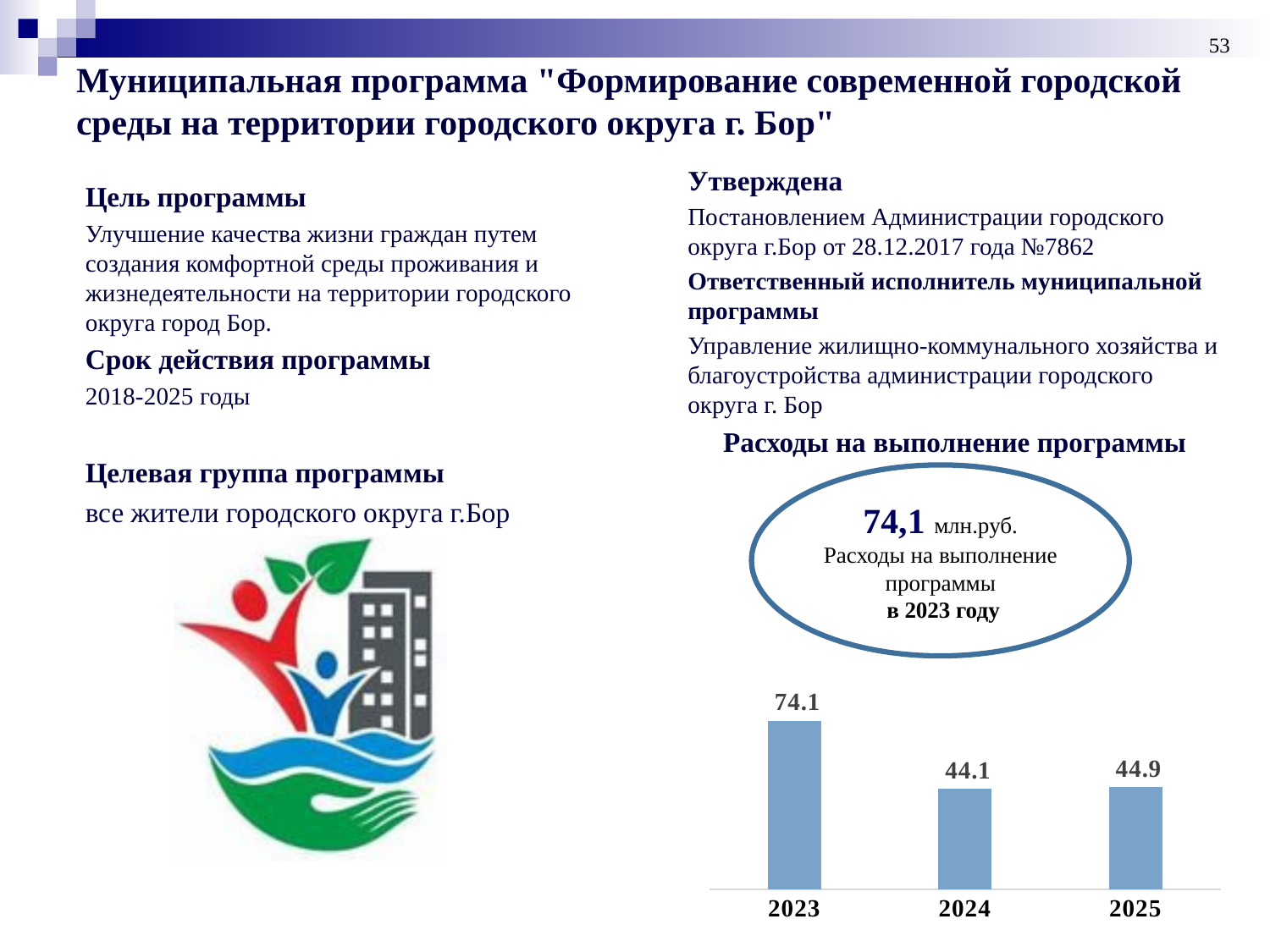
What is the value for 2023 in the chart? 74.1 What kind of chart is shown on the slide? bar chart How many years are shown in the chart? 3 Which year has the lowest value in the chart? 2024 Which year has the highest value in the chart? 2023 Do the values rise or fall from 2023 to 2024? fall What is the difference between the values for 2025 and 2024? 0.8 What is the value for 2024 in the chart? 44.1 What is the title of the chart? Расходы на выполнение программы What is the difference between the values for 2023 and 2024? 30 What is the value for 2025 in the chart? 44.9 Which is larger, the value for 2023 or the value for 2025? 2023